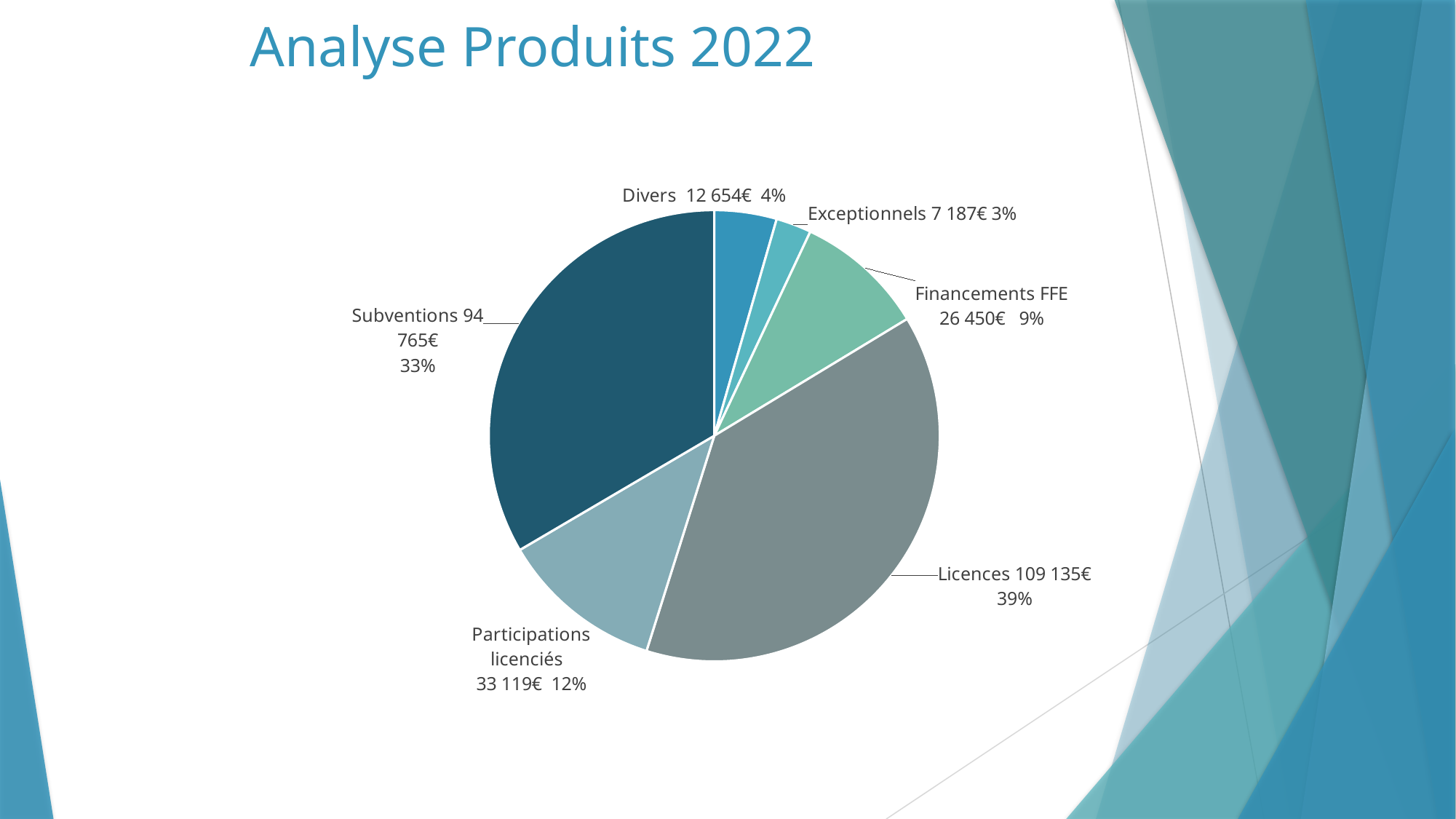
Which category has the largest slice? Licences Which is larger, Divers or Financements FFE? Financements FFE What share of the pie does Exceptionnels represent? 3% What is the value for Financements FFE? 26 450€ What is the value for Subventions? 94 765€ How many slices does the pie chart have? 6 Which category has the smallest slice? Exceptionnels What is the title of the slide? Analyse Produits 2022 What share of the pie does Participations licenciés represent? 12% What is the value for Licences? 109 135€ What kind of chart is shown on the slide? pie chart What is the difference between the Licences value and the Subventions value? 14 370€